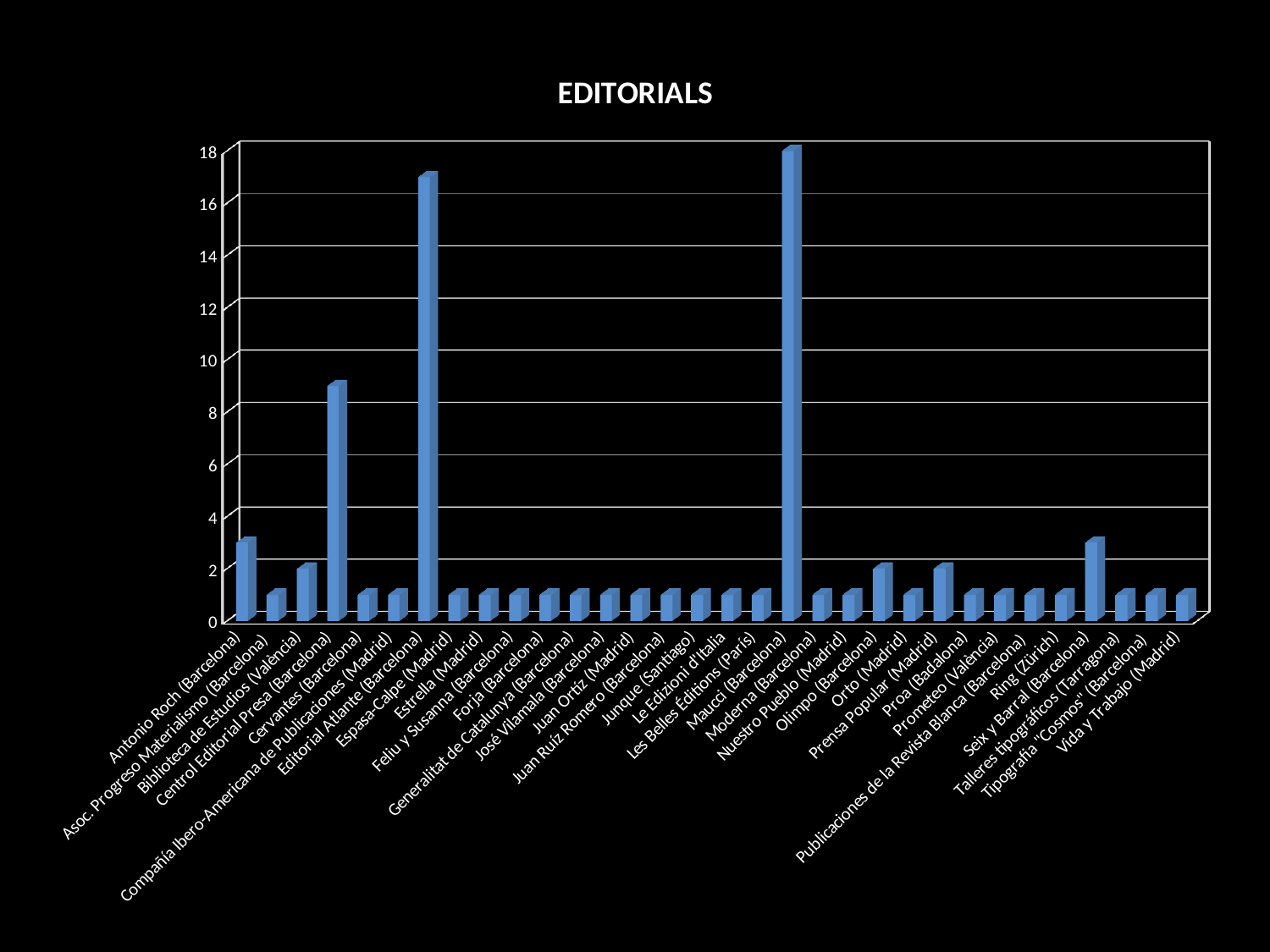
Which is larger, the value for Maucci (Barcelona) or the value for Seix y Barral (Barcelona)? Maucci (Barcelona) Is the value for Seix y Barral (Barcelona) greater or less than 6? less Is the value for Cervantes (Barcelona) greater or less than 4? less Is the value for Centro Editorial Presa (Barcelona) greater or less than 6? greater Which is larger, the value for Editorial Atlante (Barcelona) or the value for Centro Editorial Presa (Barcelona)? Editorial Atlante (Barcelona) Which category has the highest value in the chart? Maucci (Barcelona) What is the title of the chart? EDITORIALS What is the highest value shown on the vertical axis? 18 What type of chart is shown on the slide? bar chart